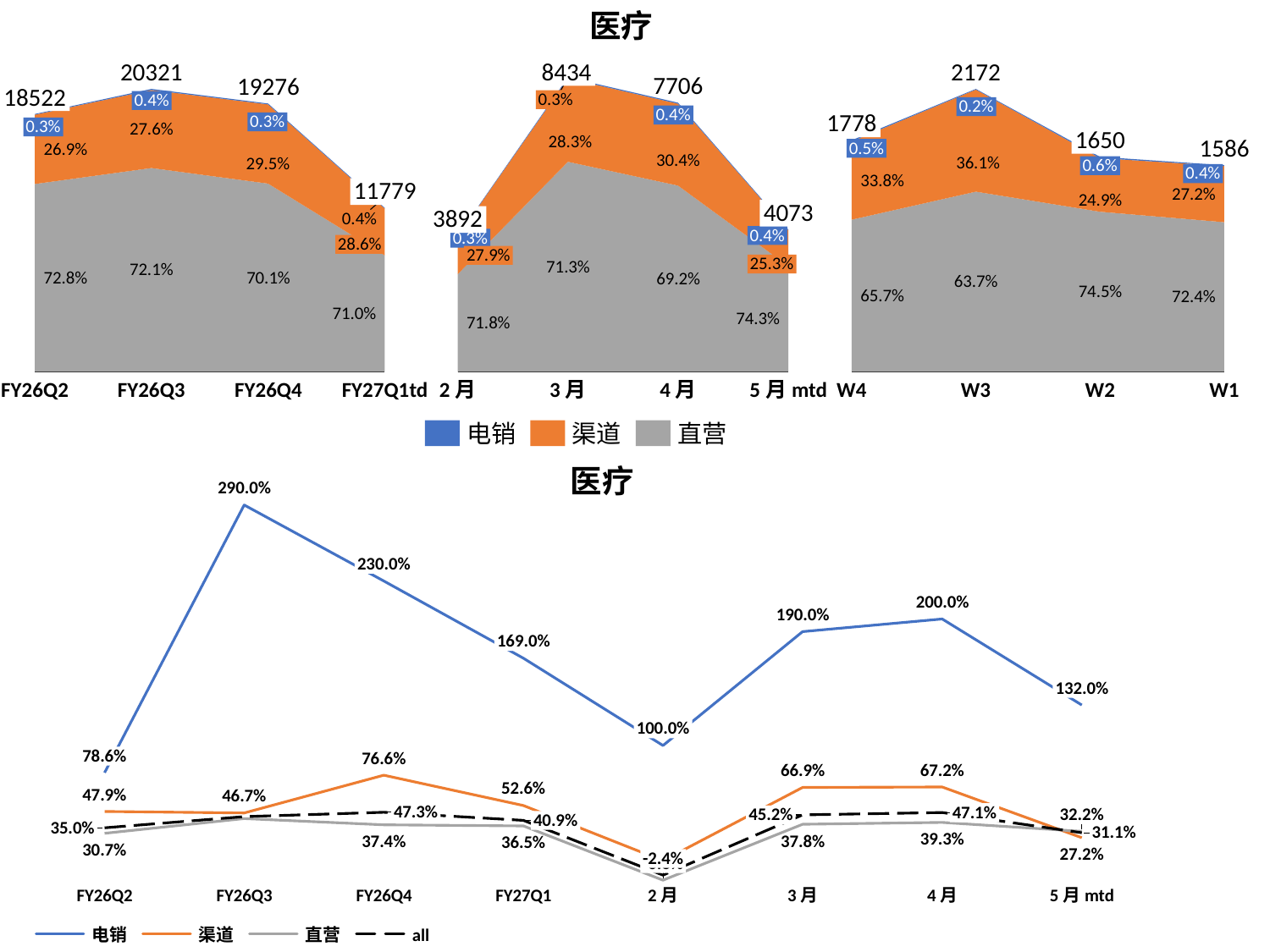
In the top chart, what is the 直营 share for W2? 74.5% In the top chart, what is the difference between the totals for 3月 and 4月? 728 In the bottom chart, what is the 渠道 value at FY26Q4? 76.6% In the top chart, which of the quarterly periods (FY26Q2 to FY27Q1td) has the highest total? FY26Q3 In the top chart, which has the larger 直营 share, W4 or W1? W1 What kind of chart is the bottom chart? Line chart How many series does the legend of the bottom chart list? 4 In the top chart, what is the 渠道 share for W3? 36.1% In the top chart, what is the total value shown for FY26Q3? 20321 In the bottom chart, what is the 电销 value at FY26Q3? 290.0% In the bottom chart, at which period does the 电销 line reach its highest value? FY26Q3 How many series does the legend of the top chart list? 3